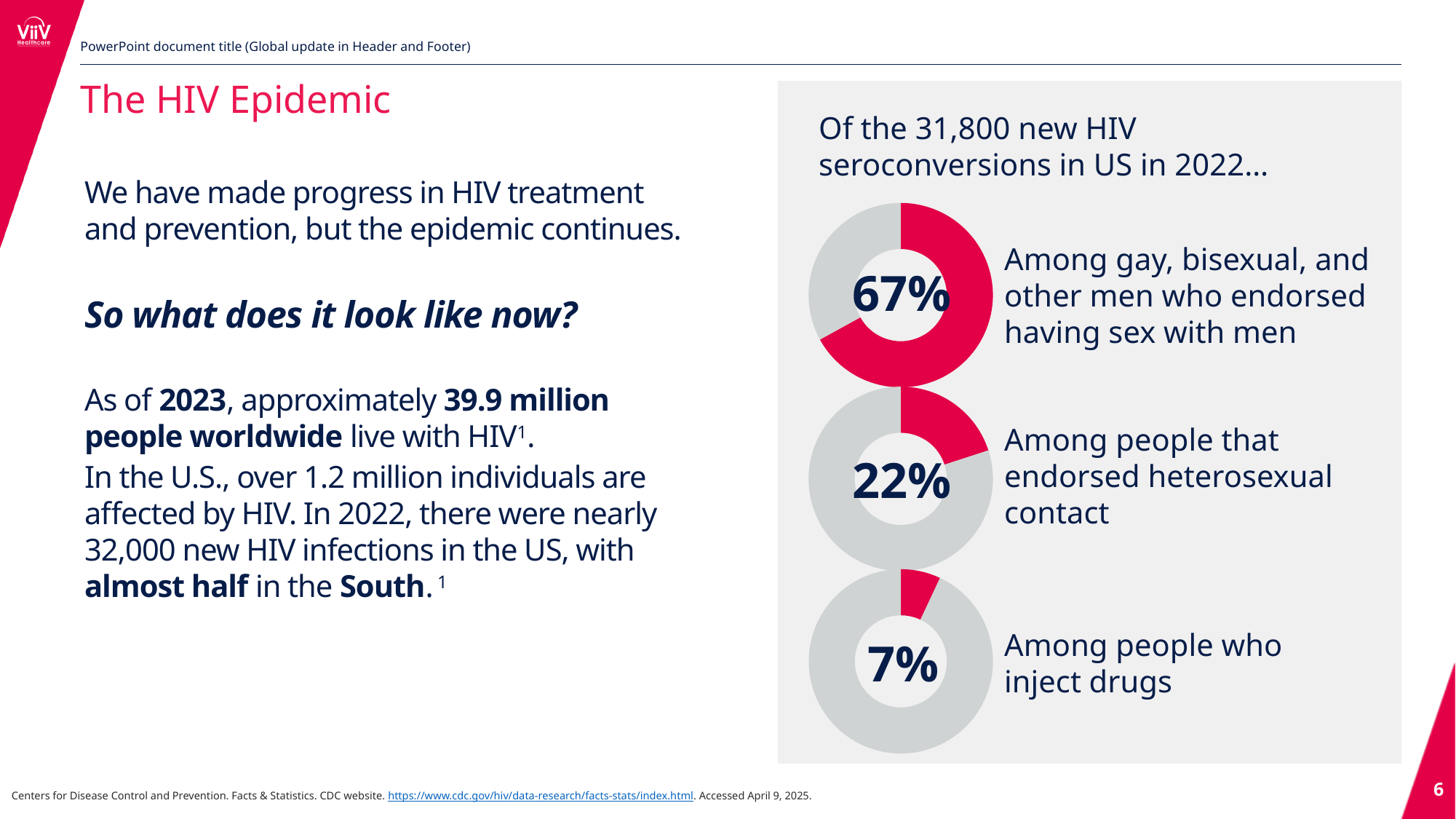
According to the heading above the donut charts, how many new HIV seroconversions were there in the US in 2022? 31,800 What colour is used for the highlighted (filled) portion of each donut chart? Red (pink-red) How many donut charts are shown on the right side of the slide? 3 What is the difference in percentage points between the top donut chart (67%) and the middle donut chart (22%)? 45 percentage points What kind of chart is used to show the 67%, 22% and 7% figures on the slide? Donut (pie) chart In the bottom donut chart, what percentage of new HIV seroconversions was among people who inject drugs? 7% In the middle donut chart, what share of new HIV seroconversions was among people that endorsed heterosexual contact? 22% Across the three donut charts, which group has the lowest share of new HIV seroconversions? People who inject drugs Across the three donut charts, which group has the highest share of new HIV seroconversions? Gay, bisexual, and other men who endorsed having sex with men What percentage of new HIV seroconversions in the US in 2022 were among gay, bisexual, and other men who endorsed having sex with men, according to the top donut chart? 67% What is the difference in percentage points between the share for people that endorsed heterosexual contact and the share for people who inject drugs? 15 percentage points Which is larger: the share for people that endorsed heterosexual contact or the share for people who inject drugs? People that endorsed heterosexual contact